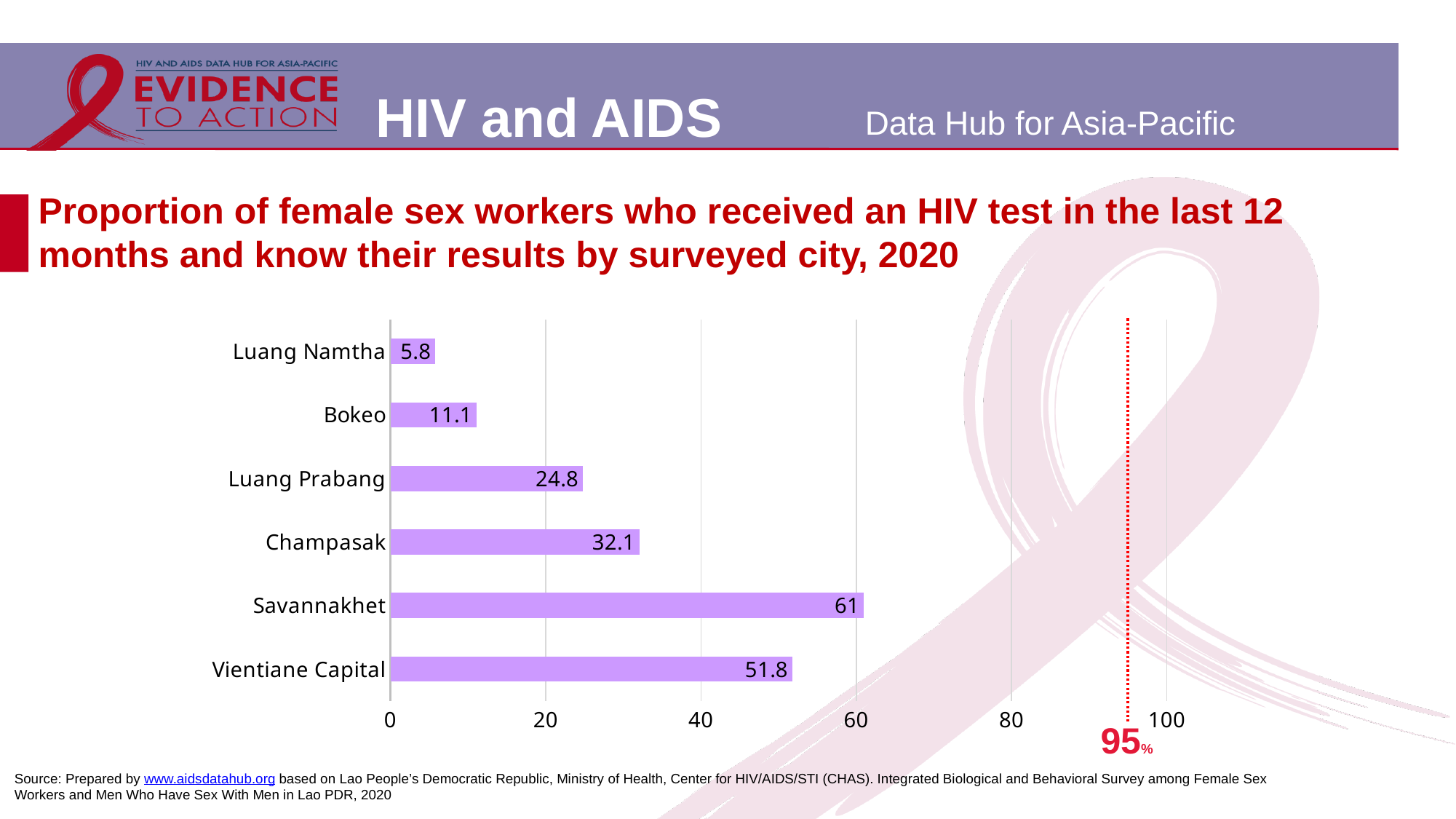
What is the value for Savannakhet? 61 Which city has the highest value? Savannakhet Which city has the lowest value? Luang Namtha Which is larger, the value for Champasak or the value for Luang Prabang? Champasak What is the value for Vientiane Capital? 51.8 What is the value for Champasak? 32.1 How many cities are shown in the chart? 6 Is the value for Bokeo greater or less than 20? less What is the difference between the values for Savannakhet and Vientiane Capital? 9.2 What is the value for Luang Namtha? 5.8 What kind of chart is shown on the slide? bar chart What is the difference between the values for Luang Prabang and Bokeo? 13.7